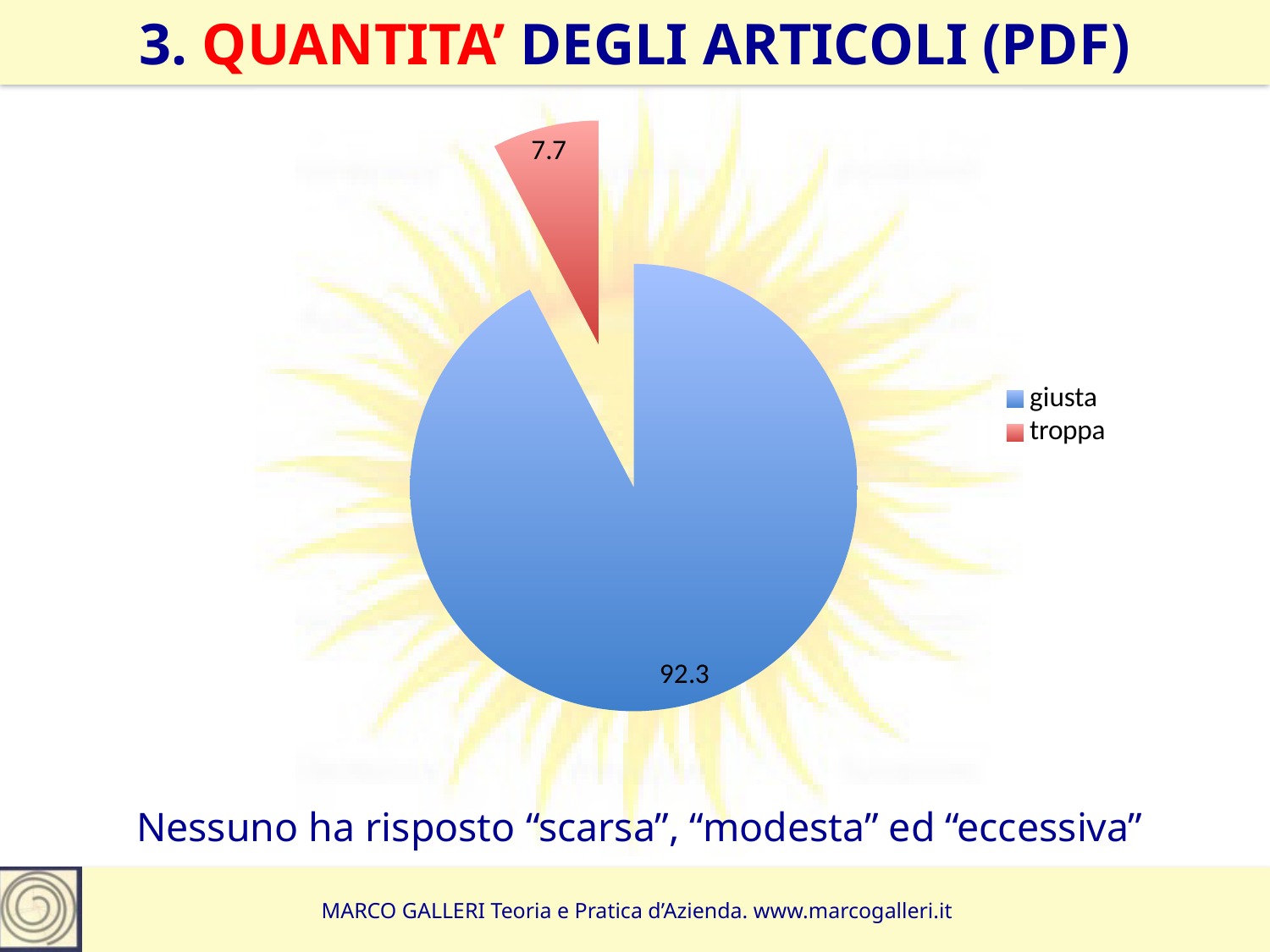
What colour is the slice for "giusta"? blue What is the value for "giusta"? 92.3 What is the difference between the values for "giusta" and "troppa"? 84.6 What kind of chart is shown on the slide? pie chart How many entries does the legend list? 2 What colour is the slice for "troppa"? red Which category has the largest slice? giusta How many slices does the pie chart have? 2 What is the value for "troppa"? 7.7 Which category has the smallest slice? troppa Which is larger, the value for "giusta" or the value for "troppa"? giusta